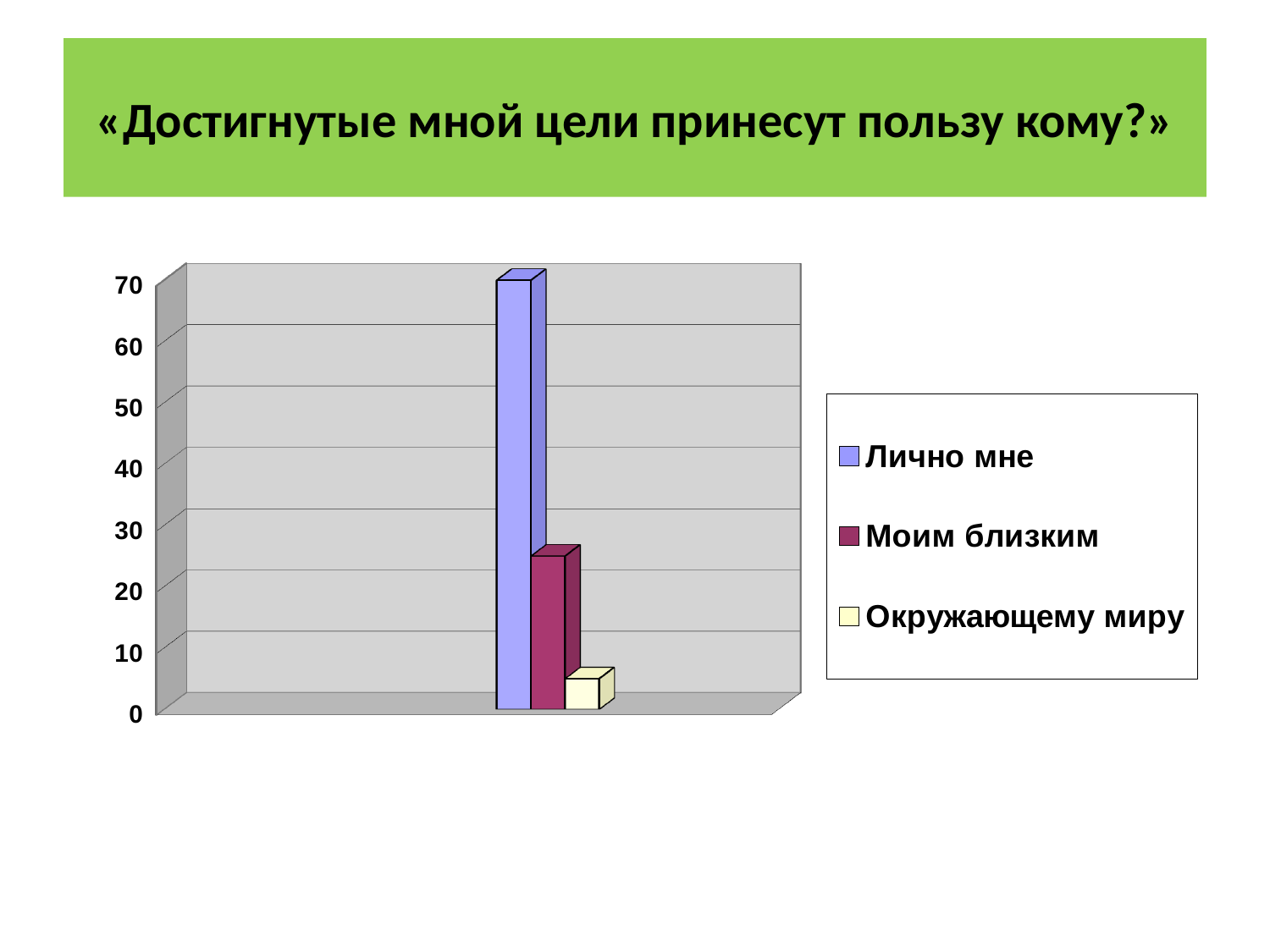
What is the title of the slide above the chart? «Достигнутые мной цели принесут пользу кому?» Is the value for Моим близким greater or less than 20? greater Which is larger, the value for Лично мне or the value for Моим близким? Лично мне Is the value for Лично мне greater or less than 60? greater Is the value for Моим близким greater or less than 30? less How many series does the legend list? 3 Which series has the lowest value? Окружающему миру Which is larger, the value for Моим близким or the value for Окружающему миру? Моим близким What kind of chart is shown on the slide? bar chart What colour is the bar for Моим близким? dark red Which series has the highest value? Лично мне